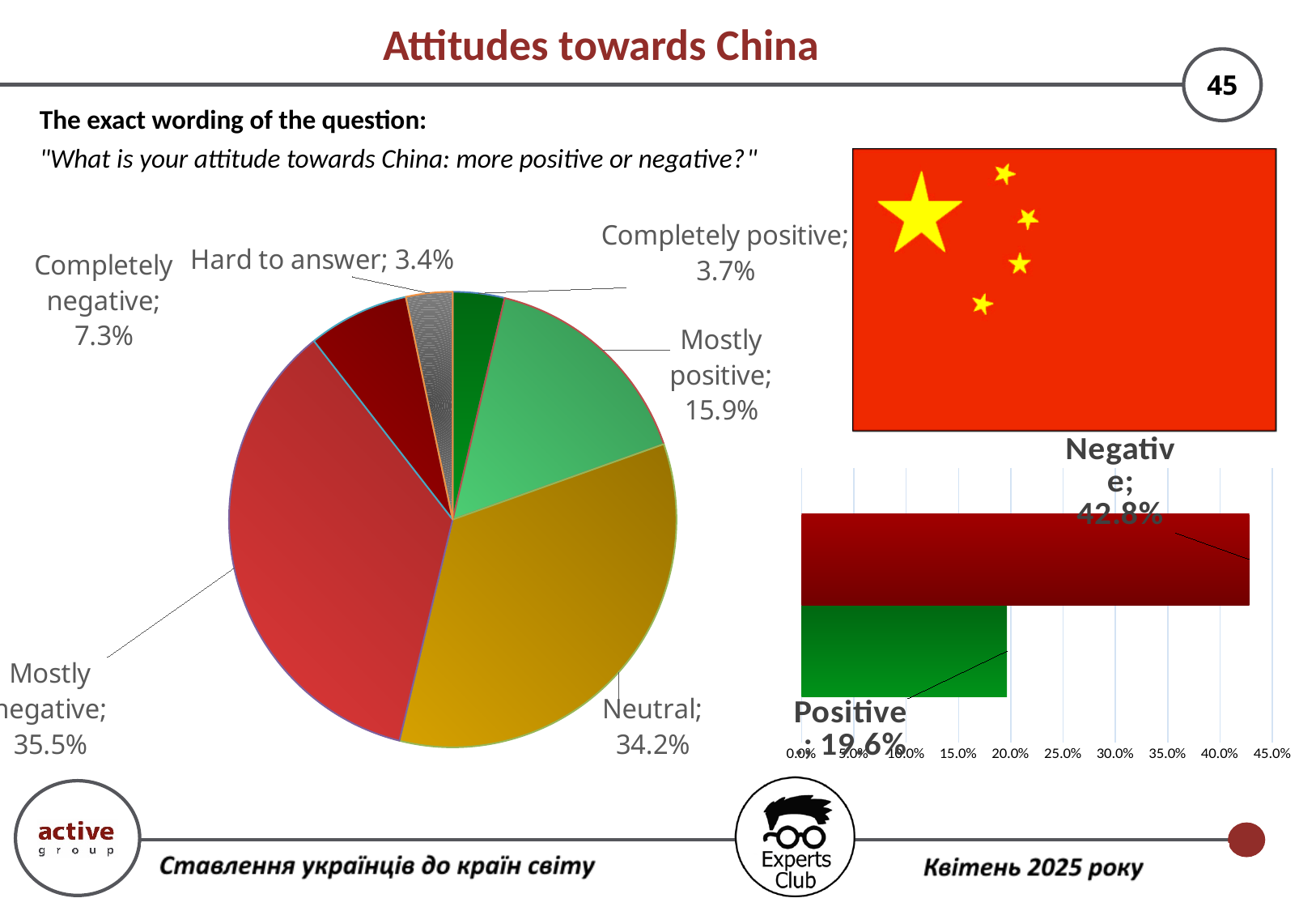
In the pie chart on the left, what share of respondents answered "Neutral"? 34.2% In the pie chart on the left, what is the difference between "Mostly negative" and "Mostly positive"? 19.6% In the bar chart on the right, what is the difference between "Negative" and "Positive"? 23.2% In the pie chart on the left, which category has the largest share? Mostly negative In the bar chart on the right, what is the value for "Negative"? 42.8% In the pie chart on the left, what is the value for "Mostly positive"? 15.9% In the pie chart on the left, which category has the smallest share? Hard to answer In the pie chart on the left, what is the value for "Completely negative"? 7.3% In the bar chart on the right, what is the value for "Positive"? 19.6% In the pie chart on the left, which is larger: "Completely negative" or "Completely positive"? Completely negative What type of chart is shown on the right side of the slide? Bar chart In the pie chart on the left, how many categories are shown? 6